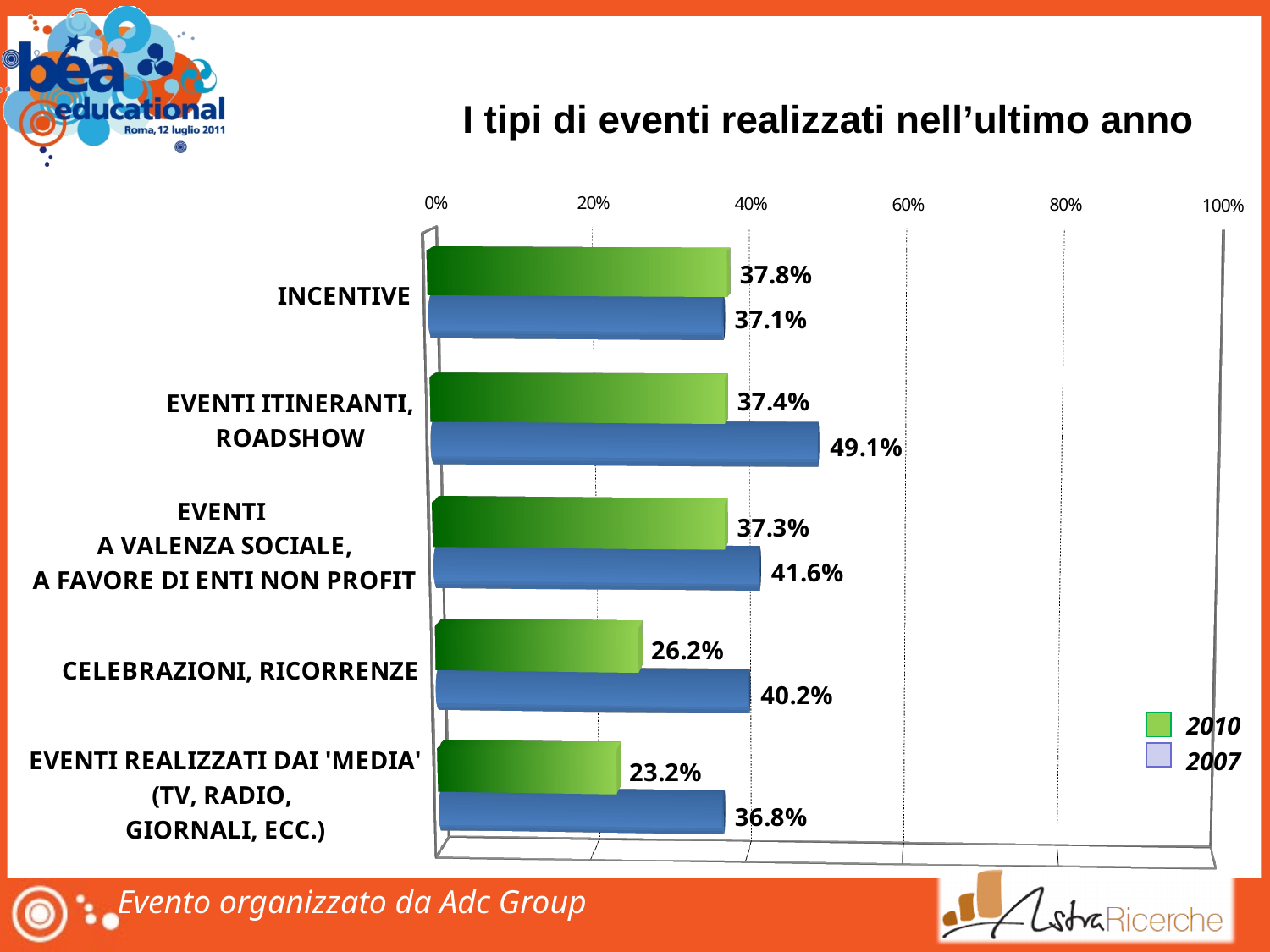
What is the 2007 value for EVENTI REALIZZATI DAI 'MEDIA' (TV, RADIO, GIORNALI, ECC.)? 36.8% What is the difference between the 2007 and 2010 values for CELEBRAZIONI, RICORRENZE? 14.0% What type of chart is shown on the slide? Bar chart For EVENTI A VALENZA SOCIALE, A FAVORE DI ENTI NON PROFIT, which year has the larger value, 2010 or 2007? 2007 How many series does the legend list? 2 How many categories are shown in the chart? 5 What is the 2010 value for INCENTIVE? 37.8% Which category has the highest 2007 value? EVENTI ITINERANTI, ROADSHOW What is the 2010 value for CELEBRAZIONI, RICORRENZE? 26.2% What is the 2007 value for EVENTI ITINERANTI, ROADSHOW? 49.1% Is the 2007 value for EVENTI ITINERANTI, ROADSHOW greater or less than 40%? greater Which category has the lowest 2010 value? EVENTI REALIZZATI DAI 'MEDIA' (TV, RADIO, GIORNALI, ECC.)